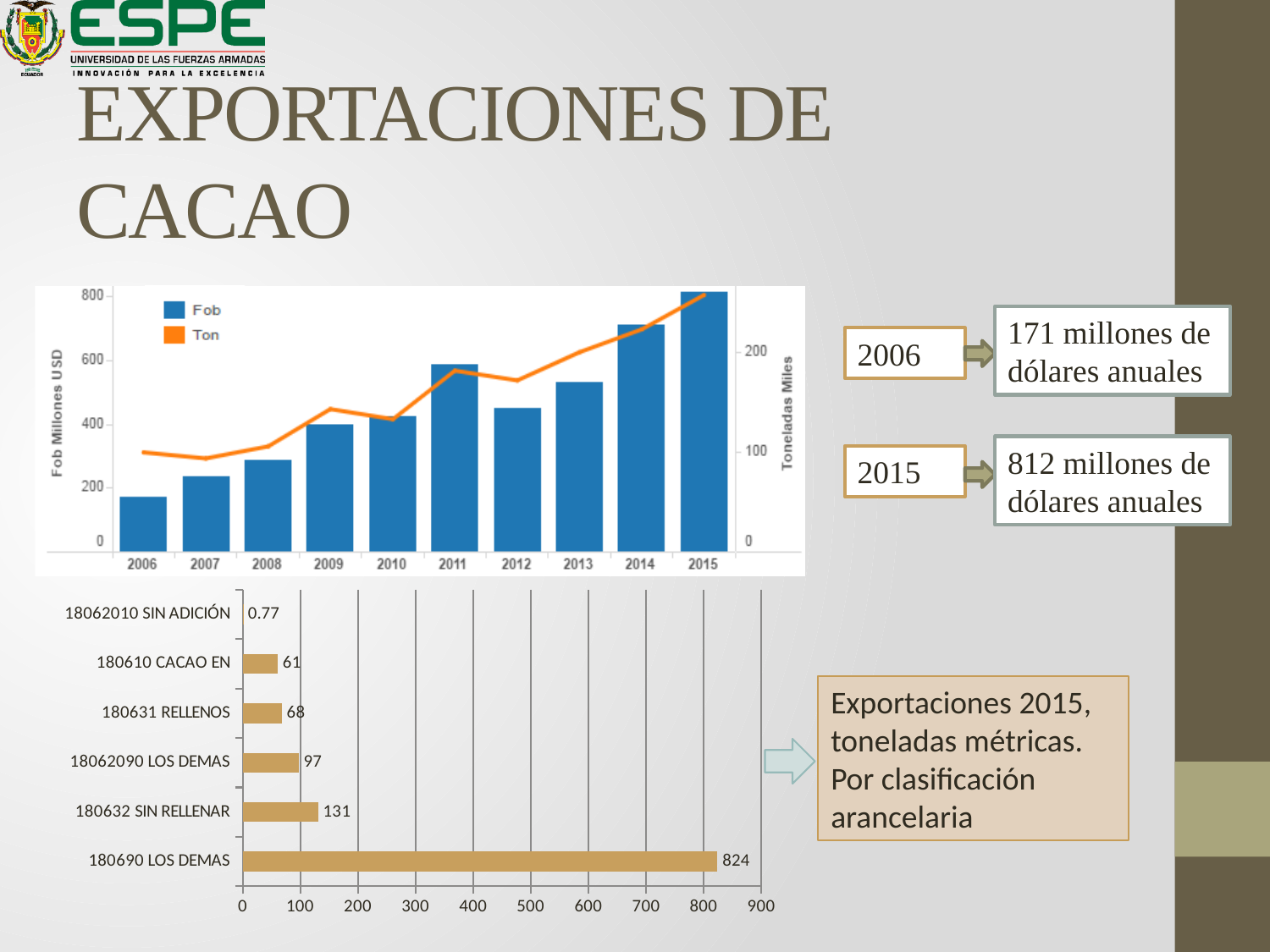
In the bottom bar chart, which is larger: the value for 18062090 LOS DEMAS or the value for 180631 RELLENOS? 18062090 LOS DEMAS In the bottom bar chart, what is the value for 180690 LOS DEMAS? 824 In the bottom bar chart, which category has the highest value? 180690 LOS DEMAS In the bottom bar chart, what is the value for 180632 SIN RELLENAR? 131 In the top chart, how many series does the legend list? 2 In the top chart, is the Fob value for 2006 greater or less than 200? less In the bottom bar chart, what is the value for 18062010 SIN ADICIÓN? 0.77 How many categories are shown in the bottom bar chart? 6 In the bottom bar chart, what is the difference between the values for 180690 LOS DEMAS and 180632 SIN RELLENAR? 693 In the bottom bar chart, which category has the lowest value? 18062010 SIN ADICIÓN In the top chart, is the Fob value for 2015 greater or less than 600? greater In the top chart, do the Fob values generally rise or fall from 2006 to 2015? rise